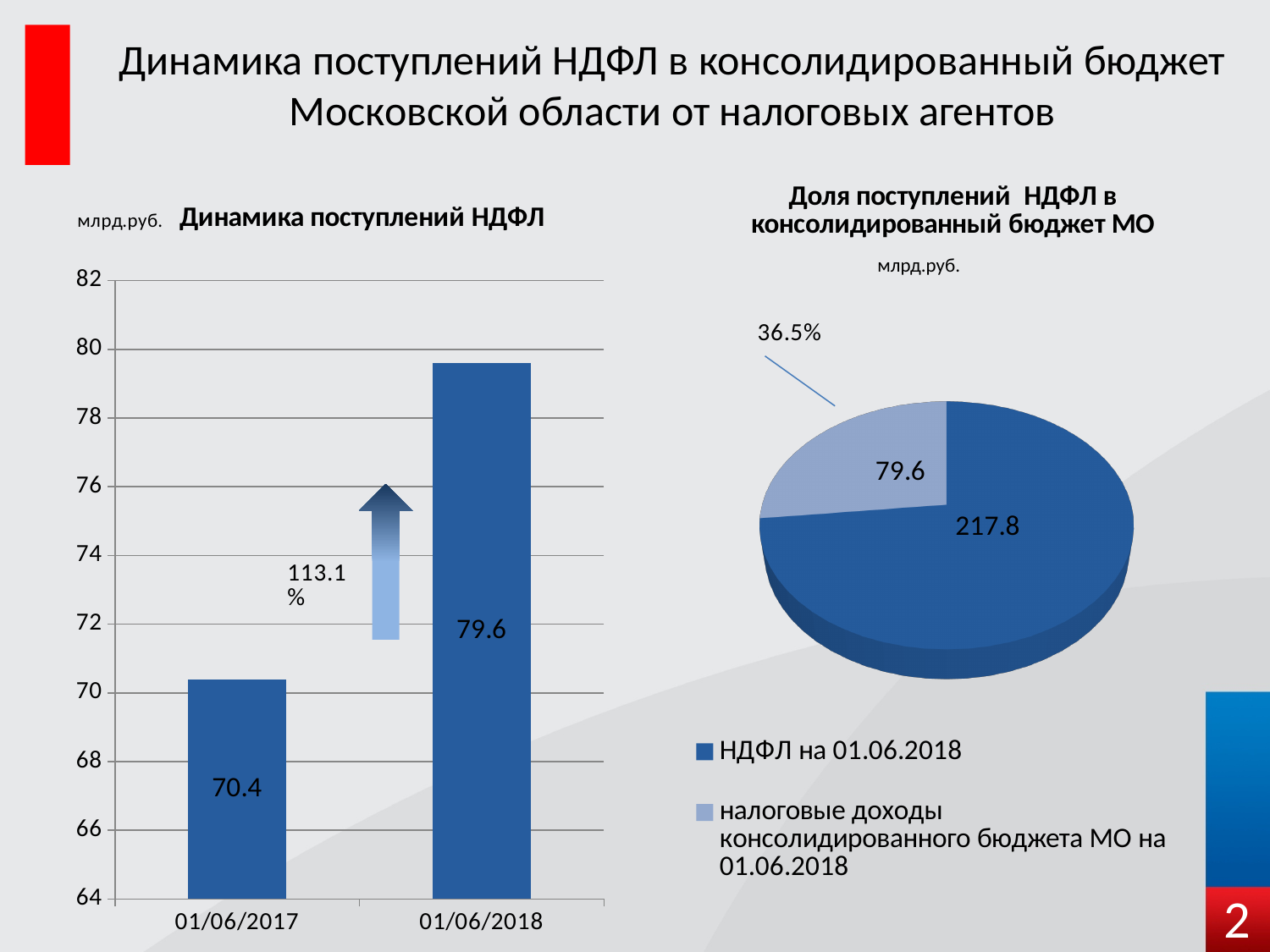
How many bars are shown in the bar chart 'Динамика поступлений НДФЛ'? 2 In the pie chart 'Доля поступлений НДФЛ в консолидированный бюджет МО', what is the value of the smaller slice? 79.6 In the bar chart 'Динамика поступлений НДФЛ', what is the difference between the values for 01/06/2018 and 01/06/2017? 9.2 In the bar chart 'Динамика поступлений НДФЛ', what is the value for 01/06/2017? 70.4 In the bar chart 'Динамика поступлений НДФЛ', what growth percentage is printed next to the arrow? 113.1% How many entries does the legend of the pie chart 'Доля поступлений НДФЛ в консолидированный бюджет МО' list? 2 In the bar chart 'Динамика поступлений НДФЛ', which date has the higher value? 01/06/2018 In the bar chart 'Динамика поступлений НДФЛ', do the values rise or fall from 01/06/2017 to 01/06/2018? rise In the pie chart 'Доля поступлений НДФЛ в консолидированный бюджет МО', what is the value of the larger slice? 217.8 What kind of chart is 'Динамика поступлений НДФЛ' on the left of the slide? bar chart In the pie chart 'Доля поступлений НДФЛ в консолидированный бюджет МО', what percentage share is printed for the smaller slice? 36.5% In the bar chart 'Динамика поступлений НДФЛ', what is the value for 01/06/2018? 79.6